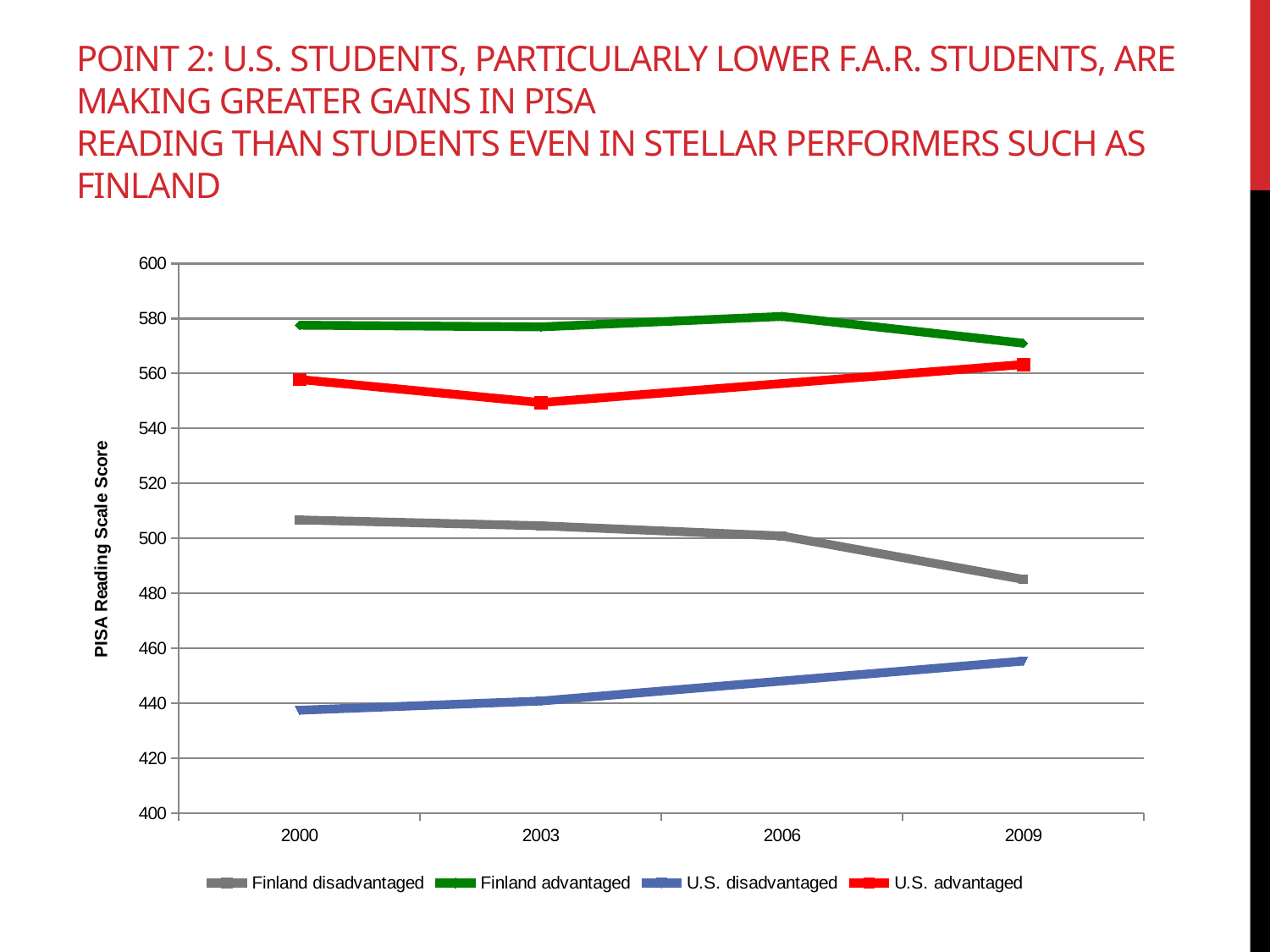
Does the U.S. disadvantaged line rise or fall from 2000 to 2009? Rises Is the value for Finland disadvantaged in 2009 greater or less than 500? less What is the title of the vertical axis? PISA Reading Scale Score Is the value for U.S. advantaged in 2003 greater or less than 560? less How many series does the legend list? 4 Which series has the highest value in 2009? Finland advantaged What kind of chart is shown on the slide? Line chart Which series has the lowest value in 2000? U.S. disadvantaged In 2006, which is higher: Finland disadvantaged or U.S. disadvantaged? Finland disadvantaged Does the Finland disadvantaged line rise or fall from 2000 to 2009? Falls Is the value for Finland advantaged in 2000 greater or less than 560? greater How many years are shown on the x axis? 4